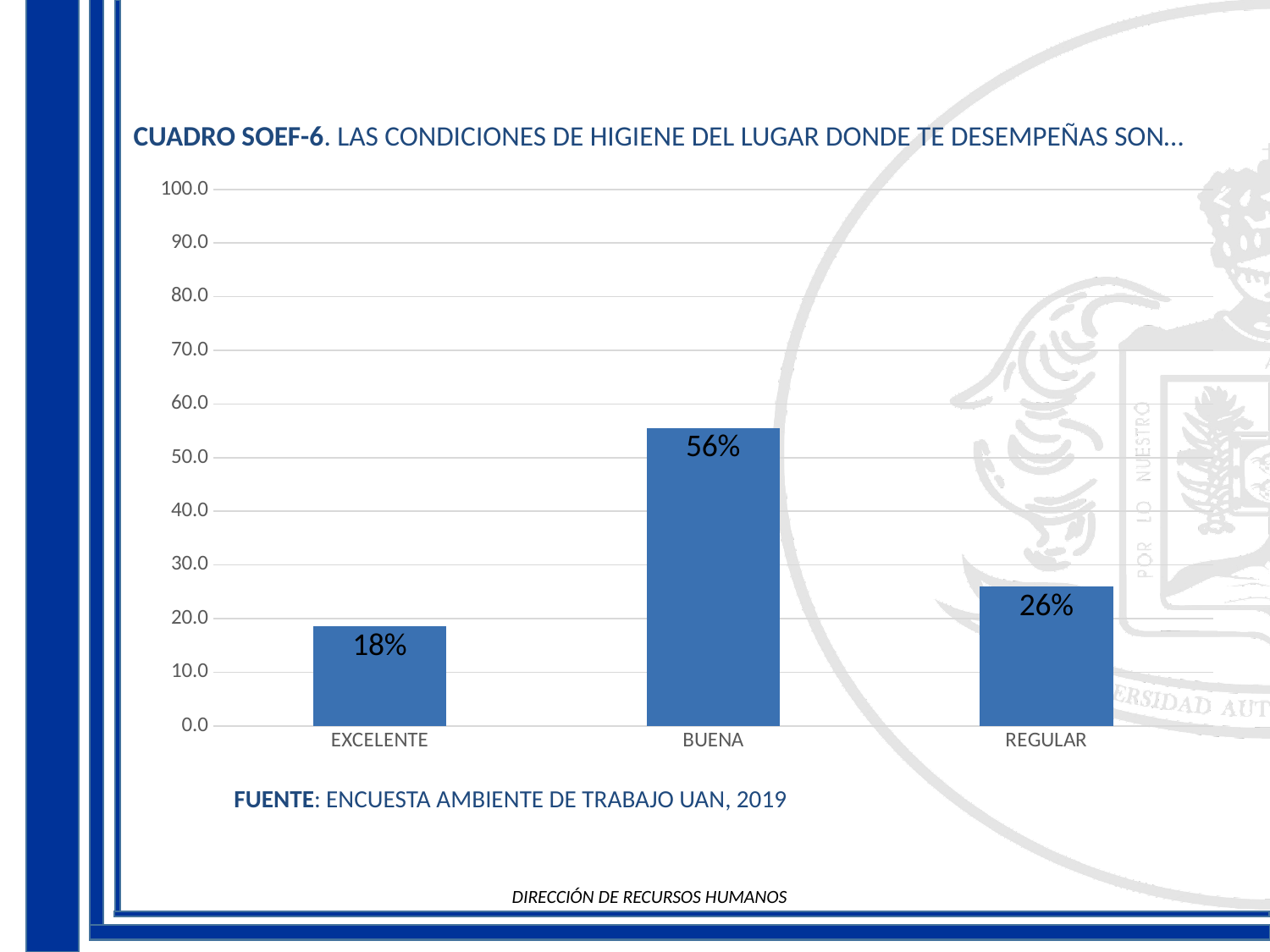
What kind of chart is shown on the slide? bar chart How many categories are shown on the x axis? 3 What is the difference between the values for REGULAR and EXCELENTE? 8% What is the difference between the values for BUENA and REGULAR? 30% Is the value for BUENA greater or less than 50.0? greater What is the value for REGULAR? 26% What is the value for BUENA? 56% What source is cited below the chart? ENCUESTA AMBIENTE DE TRABAJO UAN, 2019 What is the value for EXCELENTE? 18% Which category has the lowest value? EXCELENTE Which category has the highest value? BUENA Which is larger, the value for REGULAR or the value for EXCELENTE? REGULAR